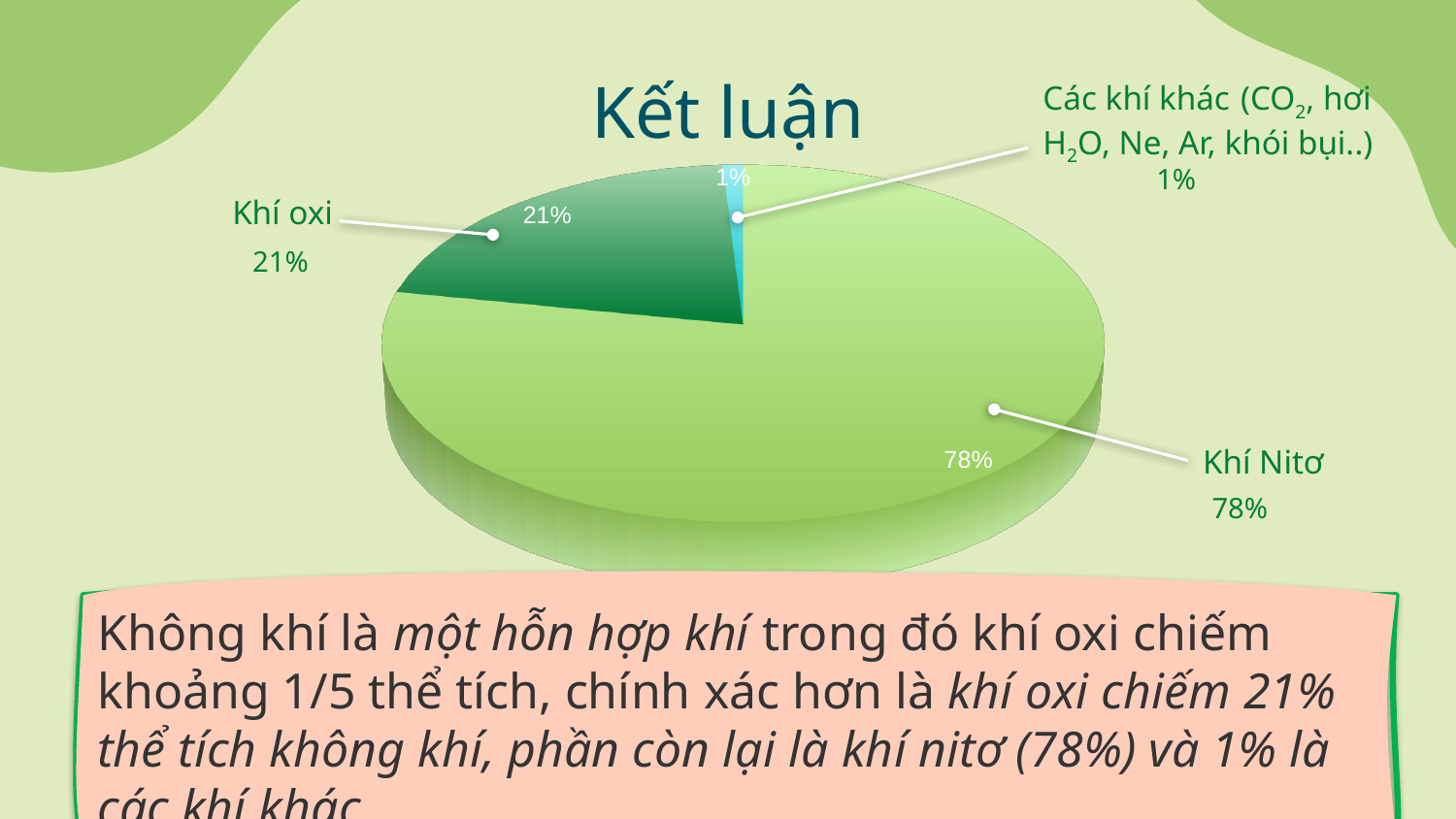
Which slice of the pie is the largest? Khí Nitơ Is the share for Khí Nitơ greater or less than 50%? greater What is the combined share of Khí oxi and Các khí khác? 22% What percentage of the pie does Khí oxi represent? 21% Which slice of the pie is the smallest? Các khí khác What is the title of the chart? Kết luận What kind of chart is shown on the slide? pie chart How many slices does the pie chart have? 3 What is the difference in percentage points between Khí Nitơ and Khí oxi? 57 Which is larger, the share for Khí oxi or the share for Các khí khác? Khí oxi What percentage of the pie do the other gases (Các khí khác) represent? 1% What percentage of the pie does Khí Nitơ represent? 78%